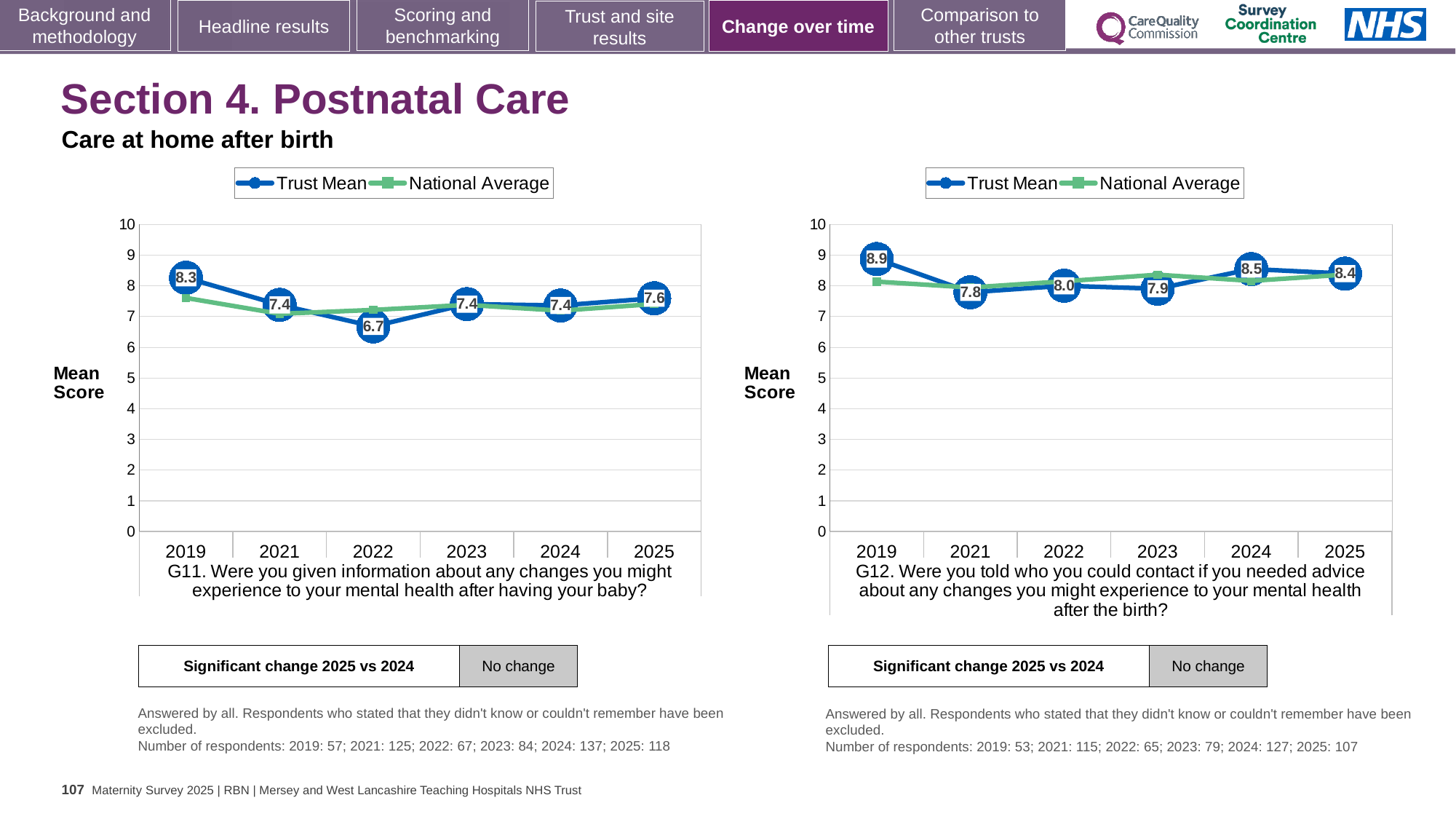
In the G11 chart (left), which year has the highest Trust Mean score? 2019 In the G12 chart (right), which year has the lowest Trust Mean score? 2021 In the G12 chart (right), is the Trust Mean score for 2025 greater or less than 8? greater In the G12 chart (right), which year has the highest Trust Mean score? 2019 In the G11 chart (left), which year has the lowest Trust Mean score? 2022 In the G12 chart (right), what is the Trust Mean score for 2024? 8.5 In the G11 chart (left), what is the Trust Mean score for 2022? 6.7 In the G11 chart (left), what is the Trust Mean score for 2019? 8.3 How many series does the legend of the G12 chart (right) list? 2 What kind of chart is the G11 chart (left)? Line chart How many years are plotted on the x axis of the G11 chart (left)? 6 In the G11 chart (left), what is the difference between the Trust Mean scores for 2019 and 2022? 1.6